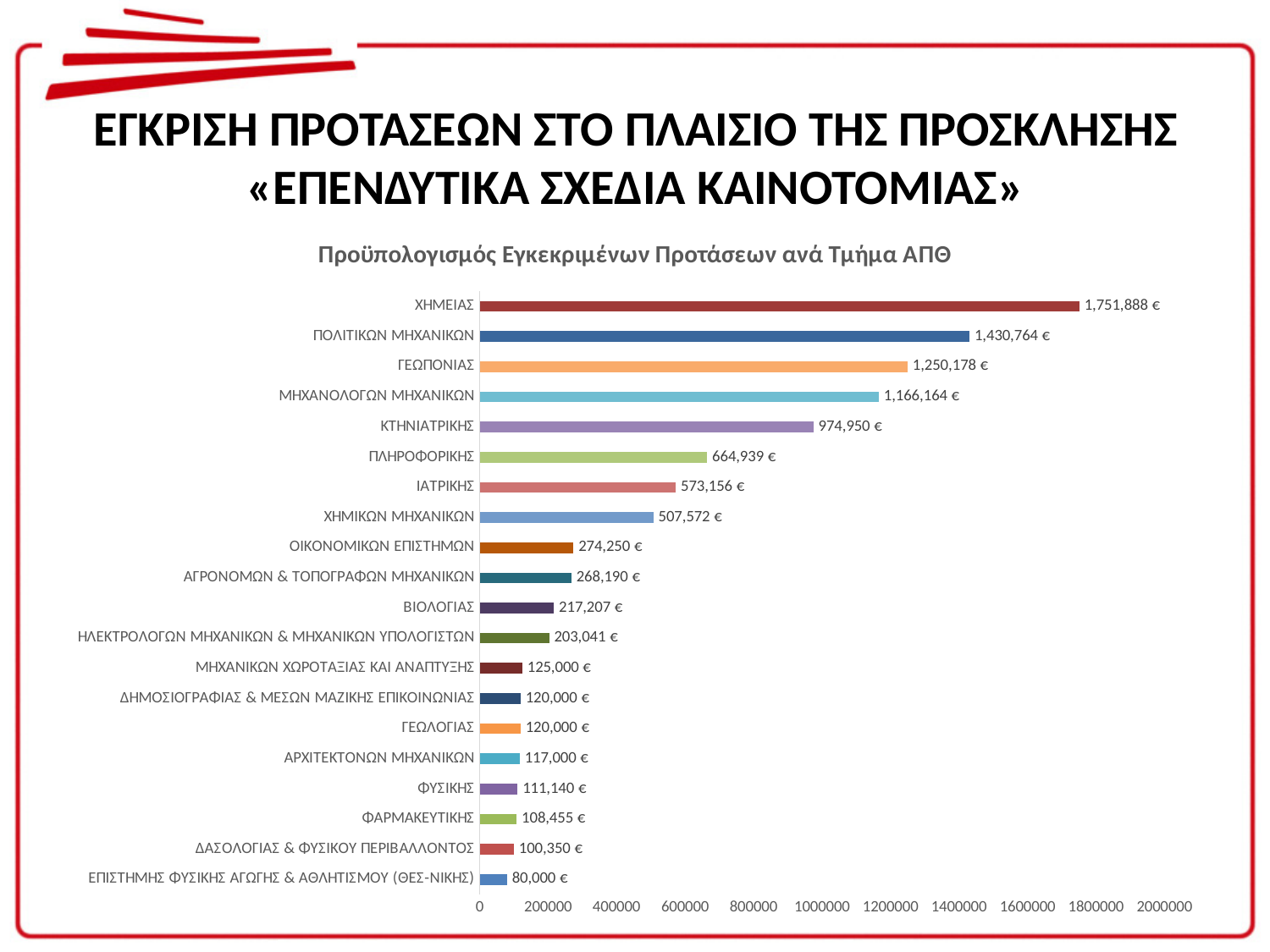
What is the difference between the budgets of ΧΗΜΕΙΑΣ and ΠΟΛΙΤΙΚΩΝ ΜΗΧΑΝΙΚΩΝ? 321,124 € What is the title of the chart? Προϋπολογισμός Εγκεκριμένων Προτάσεων ανά Τμήμα ΑΠΘ Is the value for ΙΑΤΡΙΚΗΣ greater or less than 600000? less Which has a larger approved budget, ΓΕΩΠΟΝΙΑΣ or ΜΗΧΑΝΟΛΟΓΩΝ ΜΗΧΑΝΙΚΩΝ? ΓΕΩΠΟΝΙΑΣ What is the approved budget for ΚΤΗΝΙΑΤΡΙΚΗΣ? 974,950 € Which department has the lowest approved budget? ΕΠΙΣΤΗΜΗΣ ΦΥΣΙΚΗΣ ΑΓΩΓΗΣ & ΑΘΛΗΤΙΣΜΟΥ (ΘΕΣ-ΝΙΚΗΣ) What type of chart is shown on the slide? Bar chart What is the approved budget for ΧΗΜΕΙΑΣ? 1,751,888 € How many departments are shown in the chart? 20 What is the approved budget for ΒΙΟΛΟΓΙΑΣ? 217,207 € Which department has the highest approved budget? ΧΗΜΕΙΑΣ What is the difference between the budgets of ΚΤΗΝΙΑΤΡΙΚΗΣ and ΠΛΗΡΟΦΟΡΙΚΗΣ? 310,011 €